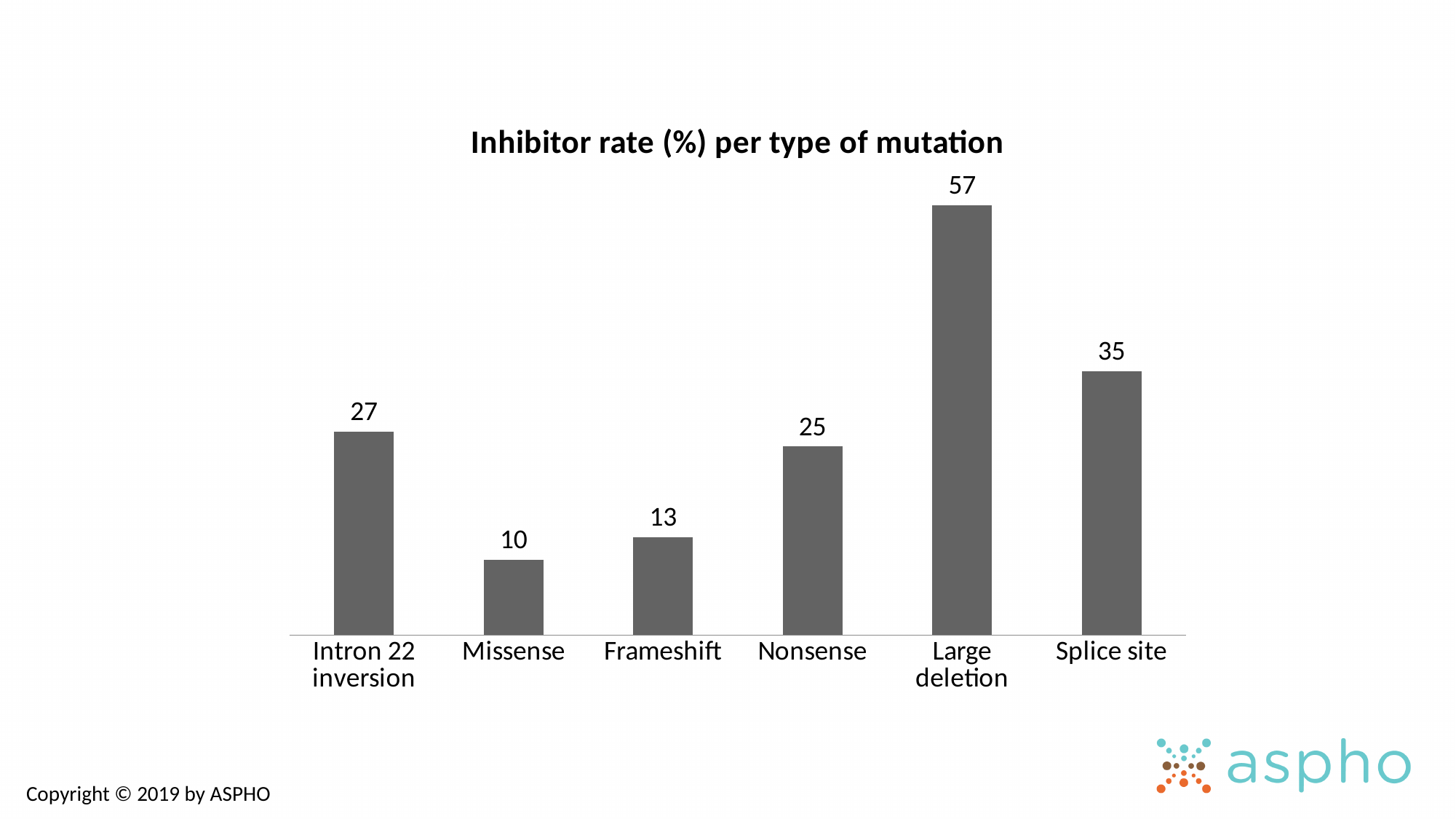
What is the inhibitor rate for Large deletion? 57 What is the title of the chart? Inhibitor rate (%) per type of mutation Which mutation type has the lowest inhibitor rate? Missense Which has a higher inhibitor rate, Intron 22 inversion or Nonsense? Intron 22 inversion What is the difference in inhibitor rate between Frameshift and Missense? 3 What type of chart is shown on the slide? Bar chart What is the inhibitor rate for Splice site mutations? 35 How many mutation types are shown in the chart? 6 What is the inhibitor rate for Missense mutations? 10 What is the inhibitor rate for Intron 22 inversion? 27 Which mutation type has the highest inhibitor rate? Large deletion What is the difference in inhibitor rate between Large deletion and Splice site? 22